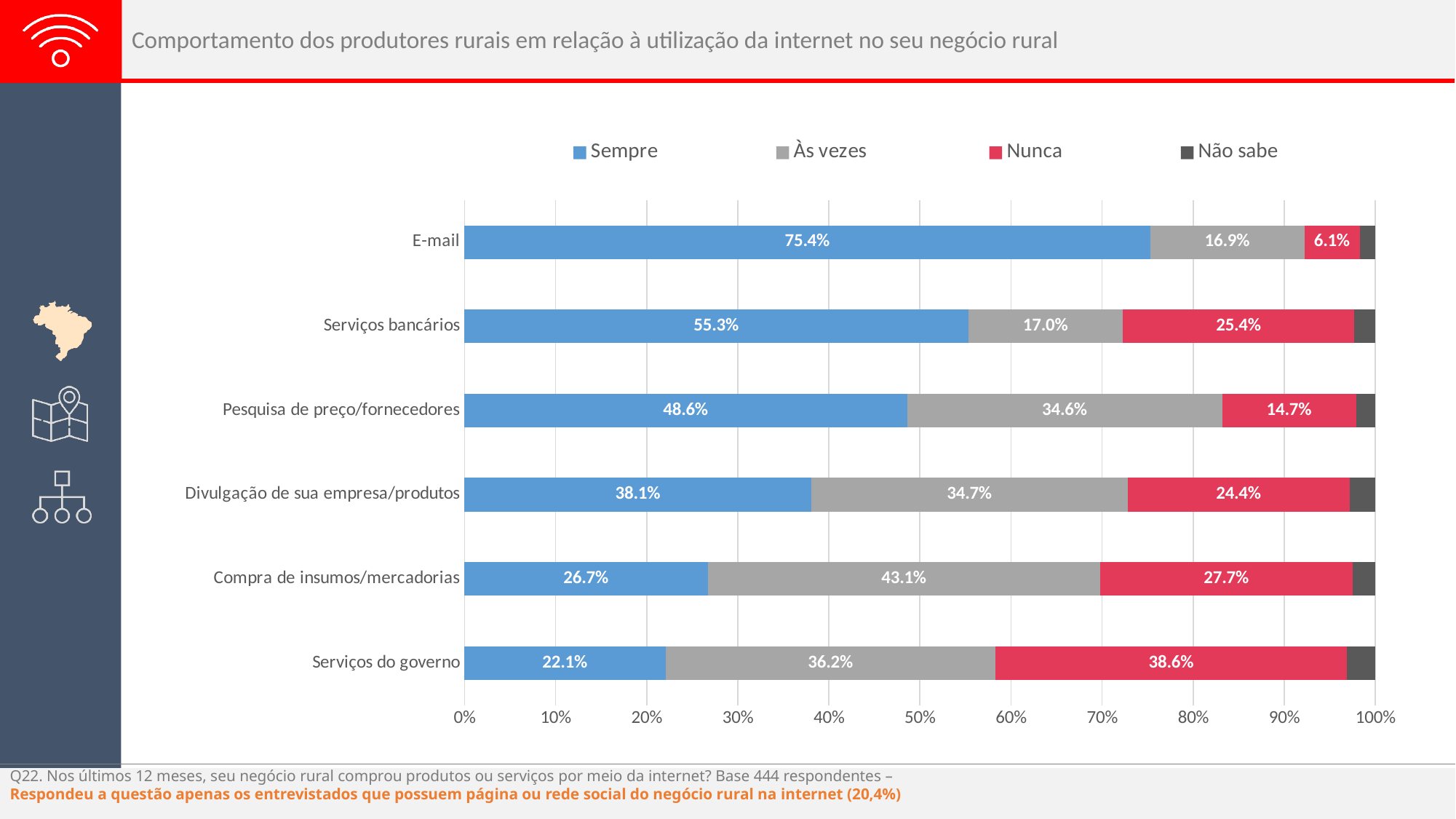
Is the 'Sempre' value for Serviços do governo greater or less than 30%? less Which category has the highest 'Sempre' value? E-mail How many categories are plotted on the chart? 6 What is the difference between the 'Sempre' values for Serviços bancários and Pesquisa de preço/fornecedores? 6.7% What is the 'Sempre' value for E-mail? 75.4% How many series does the legend list? 4 Which legend entry is shown in red? Nunca What is the 'Nunca' value for Serviços do governo? 38.6% Which is larger: the 'Nunca' value for Serviços bancários or for Divulgação de sua empresa/produtos? Serviços bancários Which category has the lowest 'Nunca' value? E-mail What kind of chart is shown on the slide? Stacked bar chart What is the 'Às vezes' value for Compra de insumos/mercadorias? 43.1%